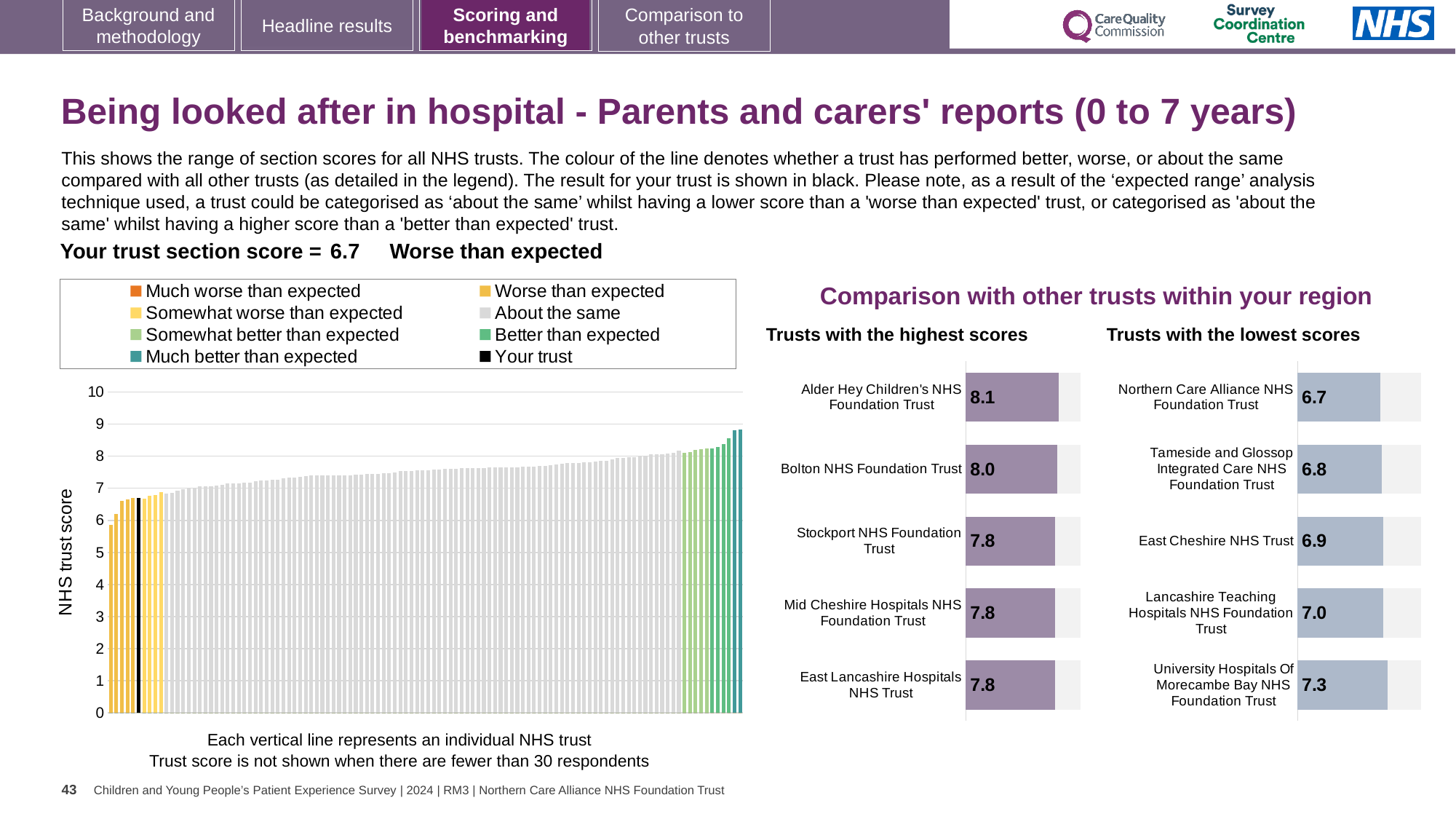
In the 'Trusts with the highest scores' chart, what is the score for Alder Hey Children's NHS Foundation Trust? 8.1 In the 'Trusts with the lowest scores' chart, which has the larger score: East Cheshire NHS Trust or Lancashire Teaching Hospitals NHS Foundation Trust? Lancashire Teaching Hospitals NHS Foundation Trust In the 'Trusts with the lowest scores' chart, which trust has the lowest score? Northern Care Alliance NHS Foundation Trust What kind of chart is the large chart on the left with the y axis labelled 'NHS trust score'? bar chart In the 'Trusts with the highest scores' chart, what is the difference between the scores of Alder Hey Children's NHS Foundation Trust and Stockport NHS Foundation Trust? 0.3 How many entries does the legend above the large chart on the left list? 8 In the 'Trusts with the highest scores' chart, which trust has the highest score? Alder Hey Children's NHS Foundation Trust In the large chart on the left, is the value of the tallest bar greater or less than 8? greater In the 'Trusts with the lowest scores' chart, what is the difference between the scores of University Hospitals Of Morecambe Bay NHS Foundation Trust and Northern Care Alliance NHS Foundation Trust? 0.6 In the 'Trusts with the lowest scores' chart, what is the score for Tameside and Glossop Integrated Care NHS Foundation Trust? 6.8 In the 'Trusts with the highest scores' chart, how many trusts are shown? 5 In the large chart on the left, do the bar heights rise or fall from left to right? rise